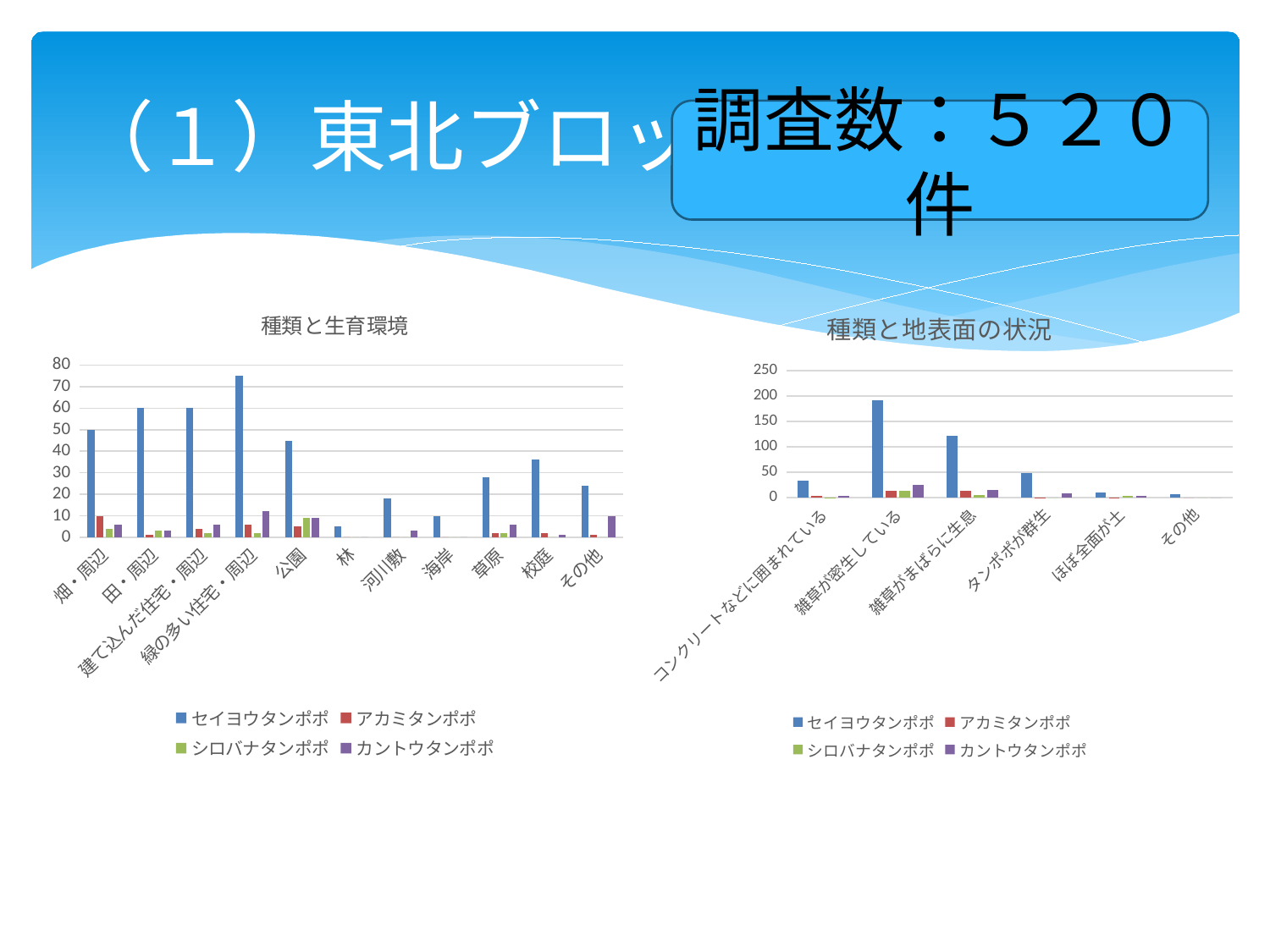
In the chart titled 種類と生育環境, which category has the lowest value for セイヨウタンポポ? 林 In the chart titled 種類と地表面の状況, is the value for セイヨウタンポポ in コンクリートなどに囲まれている greater or less than 50? less In the chart titled 種類と生育環境, is the value for セイヨウタンポポ in 河川敷 greater or less than 20? less What type of chart is the chart titled 種類と生育環境? bar chart In the chart titled 種類と生育環境, which is larger for セイヨウタンポポ: 校庭 or 草原? 校庭 In the chart titled 種類と地表面の状況, is the value for セイヨウタンポポ in 雑草が密生している greater or less than 150? greater How many series does the legend of the chart titled 種類と生育環境 list? 4 How many categories are shown on the x axis of the chart titled 種類と地表面の状況? 6 In the chart titled 種類と地表面の状況, which category has the highest value for セイヨウタンポポ? 雑草が密生している How many categories are shown on the x axis of the chart titled 種類と生育環境? 11 In the chart titled 種類と生育環境, which category has the highest value for セイヨウタンポポ? 緑の多い住宅・周辺